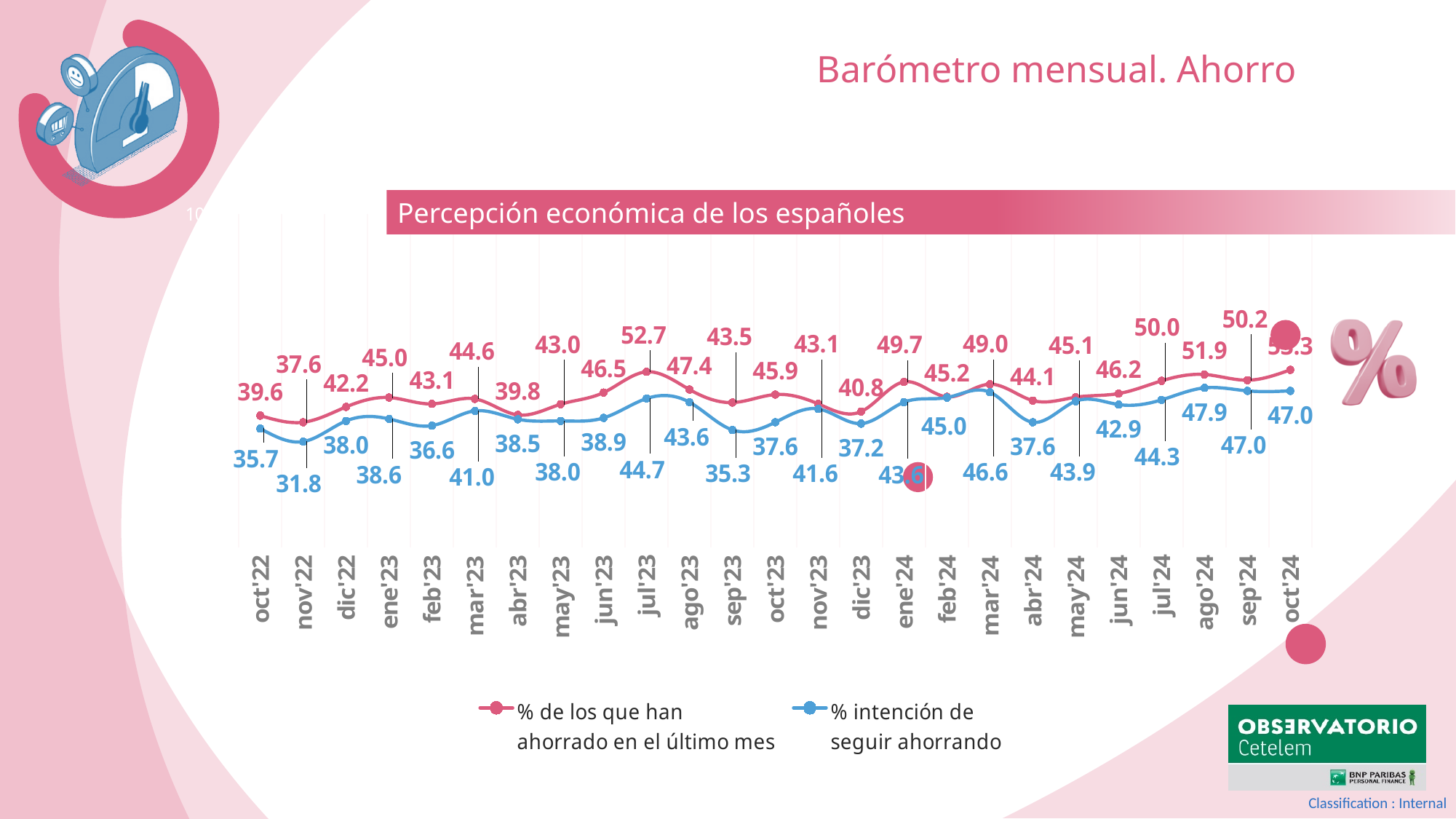
What is the value of '% de los que han ahorrado en el último mes' for ago'24? 51.9 What kind of chart is shown? line chart How many months are shown on the x axis? 25 What is the difference in '% intención de seguir ahorrando' between ago'23 and sep'23? 8.3 In jul'23, what is the difference between '% de los que han ahorrado en el último mes' and '% intención de seguir ahorrando'? 8.0 In which month is '% de los que han ahorrado en el último mes' lowest? nov'22 In which month is '% intención de seguir ahorrando' highest? ago'24 What is the value of '% de los que han ahorrado en el último mes' for jul'23? 52.7 What is the value of '% intención de seguir ahorrando' for nov'22? 31.8 How many series does the legend list? 2 Which month has a higher value for '% de los que han ahorrado en el último mes', ene'24 or feb'24? ene'24 Does '% intención de seguir ahorrando' rise or fall from oct'22 to nov'22? fall